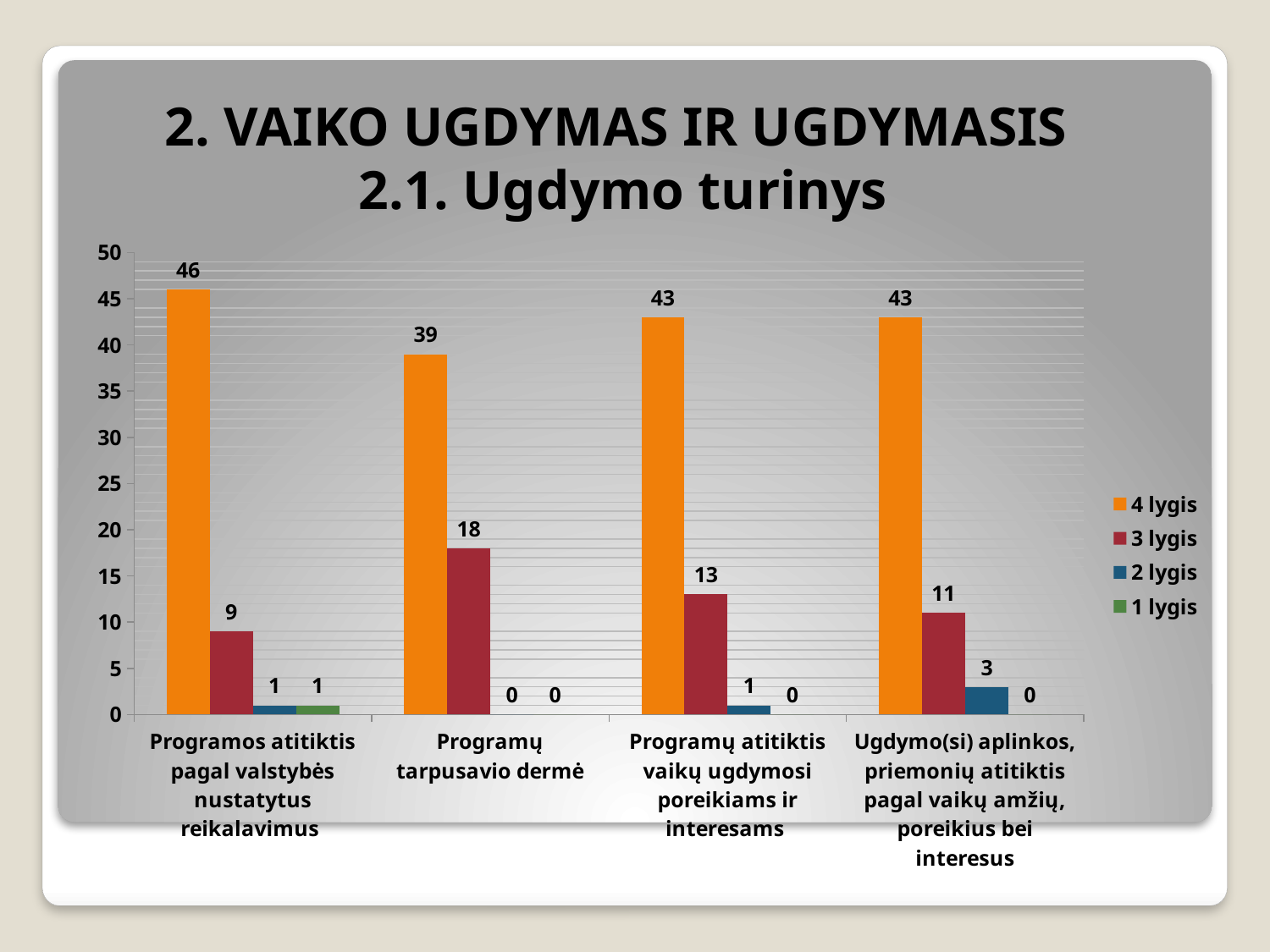
What is the value of "4 lygis" for "Programos atitiktis pagal valstybės nustatytus reikalavimus"? 46 What is the value of "2 lygis" for "Ugdymo(si) aplinkos, priemonių atitiktis pagal vaikų amžių, poreikius bei interesus"? 3 Which is larger: the "3 lygis" value for "Programų tarpusavio dermė" or for "Ugdymo(si) aplinkos, priemonių atitiktis pagal vaikų amžių, poreikius bei interesus"? Programų tarpusavio dermė What is the value of "3 lygis" for "Programų atitiktis vaikų ugdymosi poreikiams ir interesams"? 13 What is the difference between the "4 lygis" and "3 lygis" values for "Programų tarpusavio dermė"? 21 Which category has the highest "4 lygis" value? Programos atitiktis pagal valstybės nustatytus reikalavimus Which category has the lowest "4 lygis" value? Programų tarpusavio dermė What is the value of "3 lygis" for "Programų tarpusavio dermė"? 18 What kind of chart is shown on the slide? Bar chart How many categories are shown on the x axis? 4 How many series does the legend list? 4 Which colour represents "1 lygis" in the legend? Green